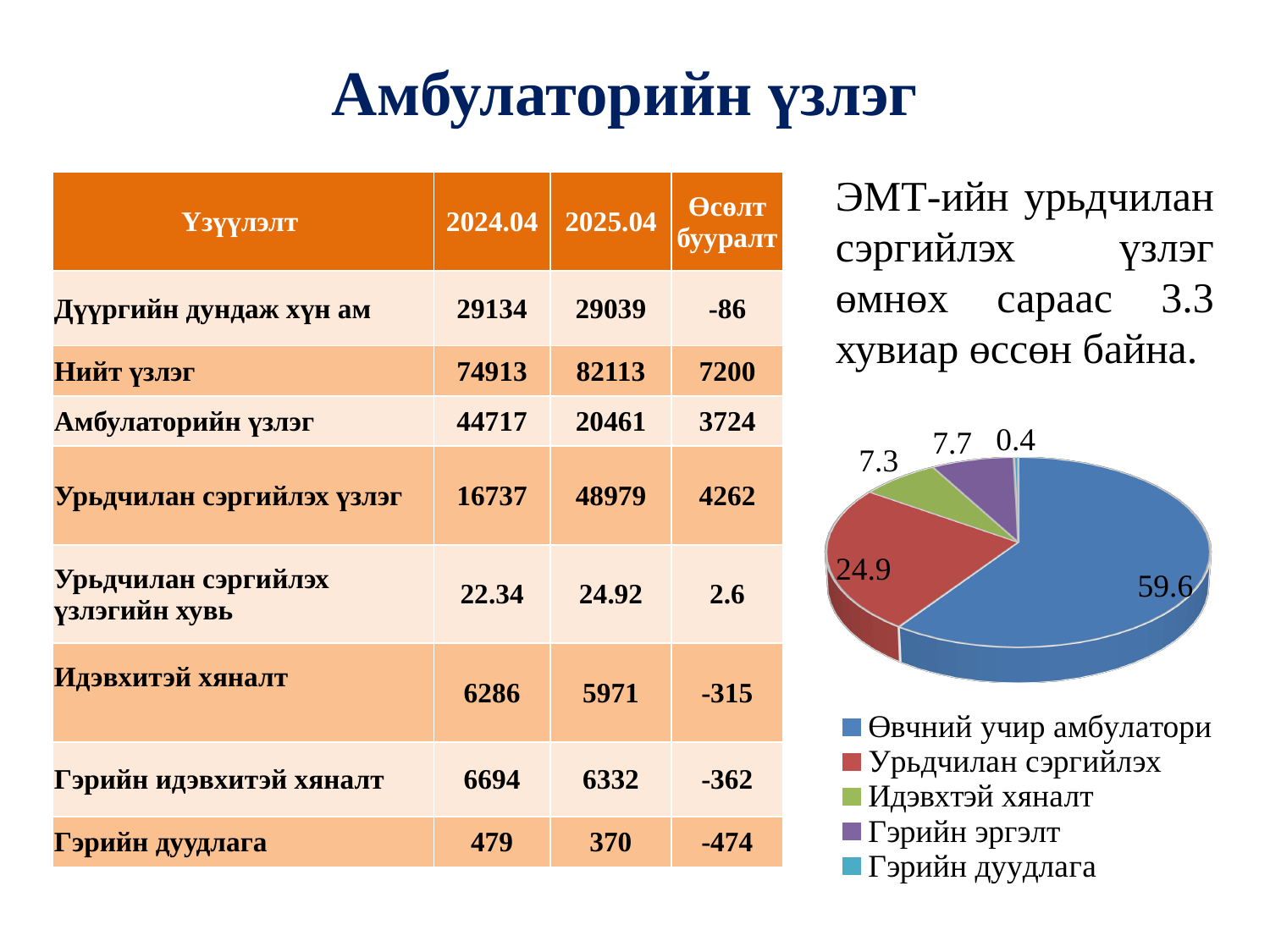
What is the value shown for Урьдчилан сэргийлэх in the pie chart? 24.9 Which category has the largest slice in the pie chart? Өвчний учир амбулатори What kind of chart is shown on the right of the slide? pie chart What colour is the slice for Өвчний учир амбулатори in the pie chart? blue How many slices does the pie chart have? 5 Which category has the smallest slice in the pie chart? Гэрийн дуудлага How many entries does the pie chart's legend list? 5 Which legend entry in the pie chart is shown in red? Урьдчилан сэргийлэх What is the value shown for Гэрийн дуудлага in the pie chart? 0.4 What is the value shown for Өвчний учир амбулатори in the pie chart? 59.6 In the pie chart, which is larger: Урьдчилан сэргийлэх or Гэрийн дуудлага? Урьдчилан сэргийлэх In the pie chart, what is the difference between the values for Өвчний учир амбулатори and Урьдчилан сэргийлэх? 34.7